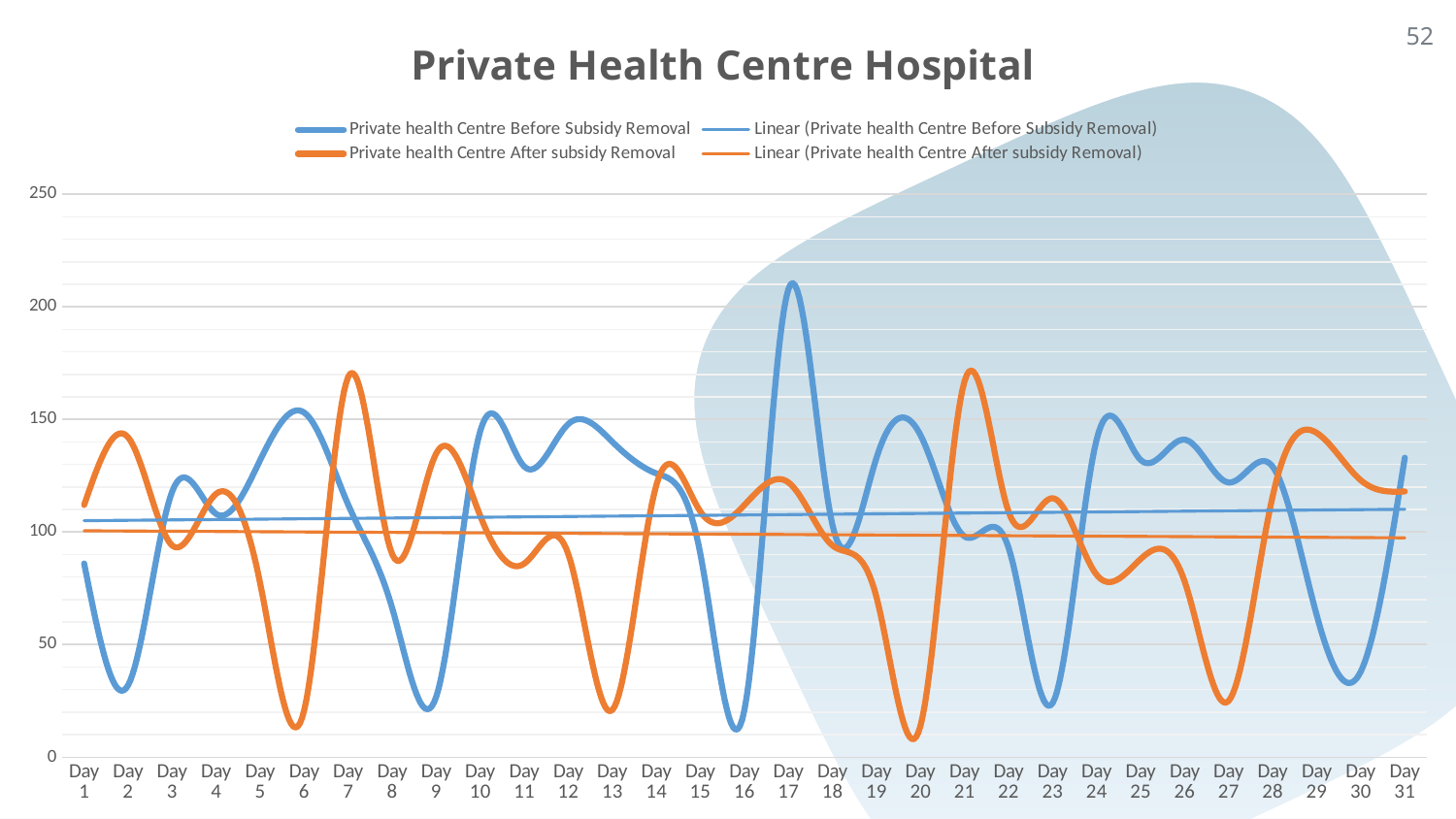
Does the linear trendline for 'Private health Centre Before Subsidy Removal' rise or fall from Day 1 to Day 31? rise How many entries does the legend list? 4 Is the value for 'Private health Centre Before Subsidy Removal' on Day 17 greater or less than 200? greater On which day does the 'Private health Centre Before Subsidy Removal' series reach its highest value? Day 17 Is the value for 'Private health Centre After subsidy Removal' on Day 2 greater or less than 100? greater On Day 7, which series has the larger value: 'Before Subsidy Removal' or 'After subsidy Removal'? After subsidy Removal What kind of chart is shown on the slide? line chart Is the value for 'Private health Centre Before Subsidy Removal' on Day 1 greater or less than 100? less Which colour represents the 'Private health Centre After subsidy Removal' series? orange What is the title of the chart? Private Health Centre Hospital How many days are plotted along the x axis? 31